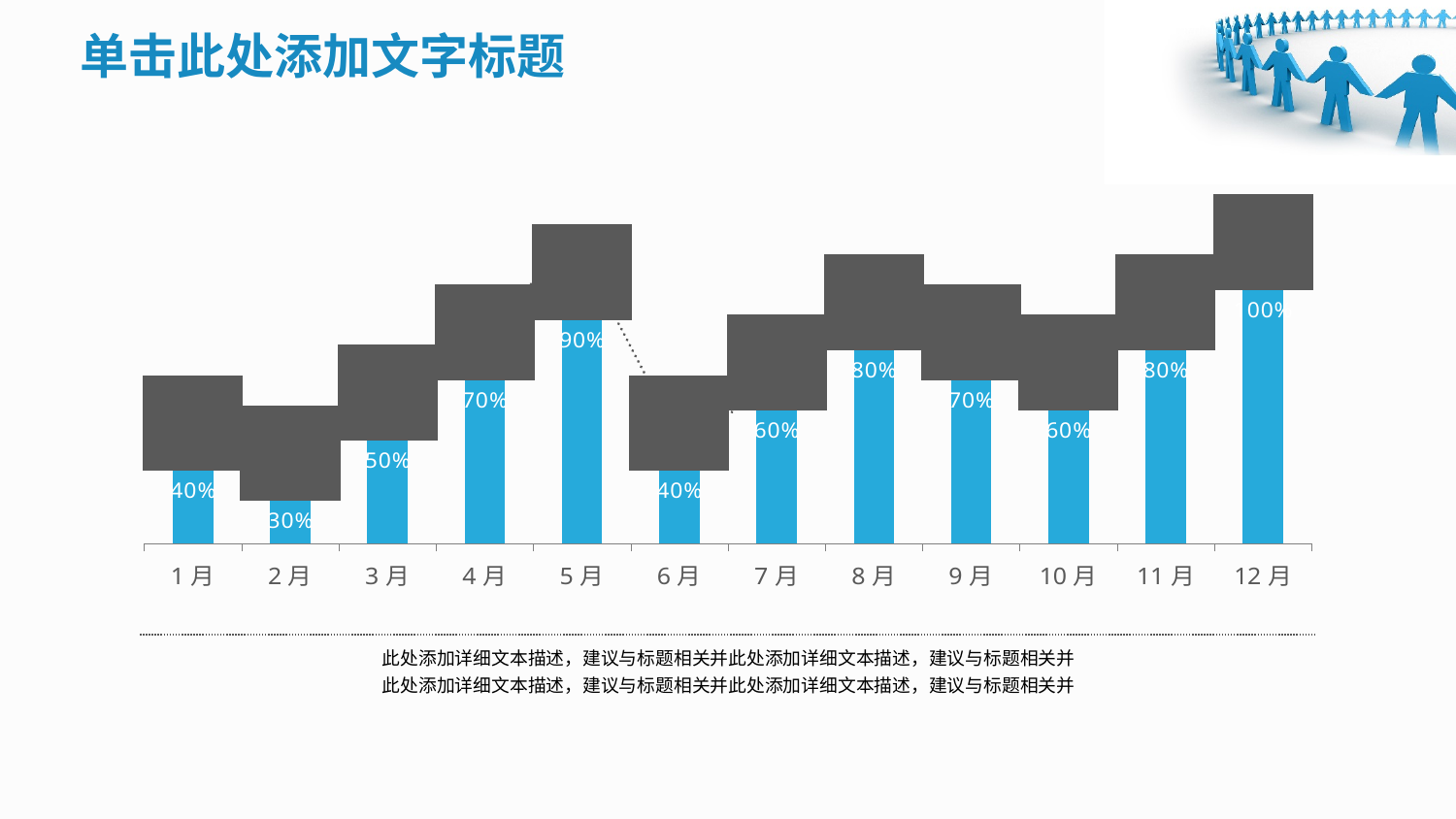
What is the value for 5 月? 90% What is the difference between the values for 5 月 and 6 月? 50% Which is larger, the value for 4 月 or the value for 7 月? 4 月 What is the value for 8 月? 80% What is the value for 1 月? 40% Do the values rise or fall from 1 月 to 5 月? rise What is the difference between the values for 3 月 and 2 月? 20% Which month has the lowest value? 2 月 How many months are shown on the x axis? 12 Which month has the highest value? 12 月 What kind of chart is this? bar chart What is the value for 10 月? 60%